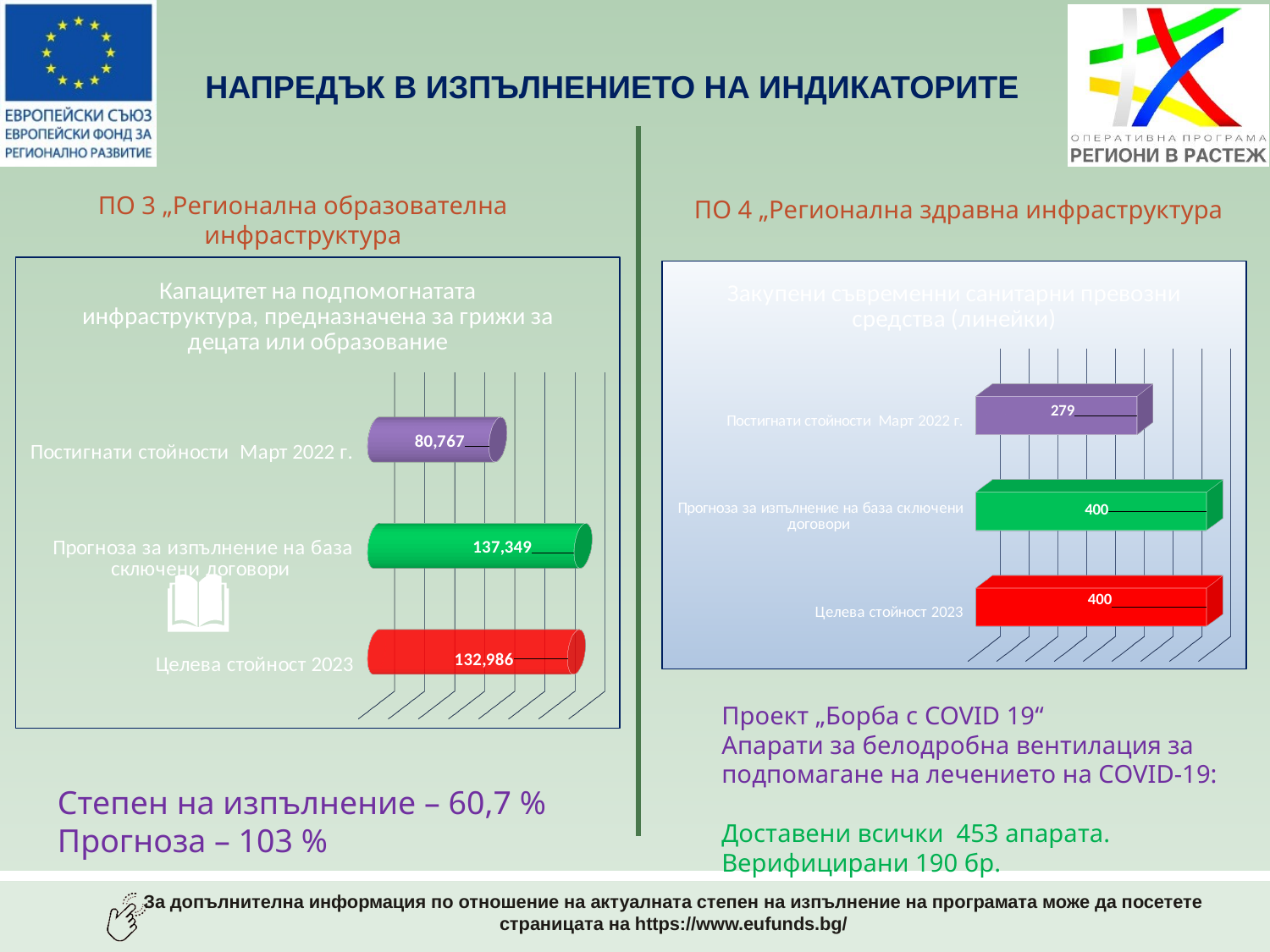
In the left chart (Капацитет на подпомогнатата инфраструктура), what is the value for Постигнати стойности Март 2022 г.? 80,767 In the left chart (Капацитет на подпомогнатата инфраструктура), which category has the lowest value? Постигнати стойности Март 2022 г. In the left chart (Капацитет на подпомогнатата инфраструктура), which category has the highest value? Прогноза за изпълнение на база сключени договори In the left chart (Капацитет на подпомогнатата инфраструктура), what is the difference between Прогноза за изпълнение на база сключени договори and Целева стойност 2023? 4,363 How many categories does the right chart (Закупени съвременни санитарни превозни средства) show? 3 What type of chart is the left chart (Капацитет на подпомогнатата инфраструктура)? Bar chart In the left chart (Капацитет на подпомогнатата инфраструктура), what is the value for Прогноза за изпълнение на база сключени договори? 137,349 In the right chart (Закупени съвременни санитарни превозни средства), which is larger: Прогноза за изпълнение на база сключени договори or Постигнати стойности Март 2022 г.? Прогноза за изпълнение на база сключени договори In the left chart (Капацитет на подпомогнатата инфраструктура), what is the value for Целева стойност 2023? 132,986 In the right chart (Закупени съвременни санитарни превозни средства), what is the value for Постигнати стойности Март 2022 г.? 279 In the right chart (Закупени съвременни санитарни превозни средства), what is the difference between Целева стойност 2023 and Постигнати стойности Март 2022 г.? 121 In the right chart (Закупени съвременни санитарни превозни средства), what is the value for Целева стойност 2023? 400